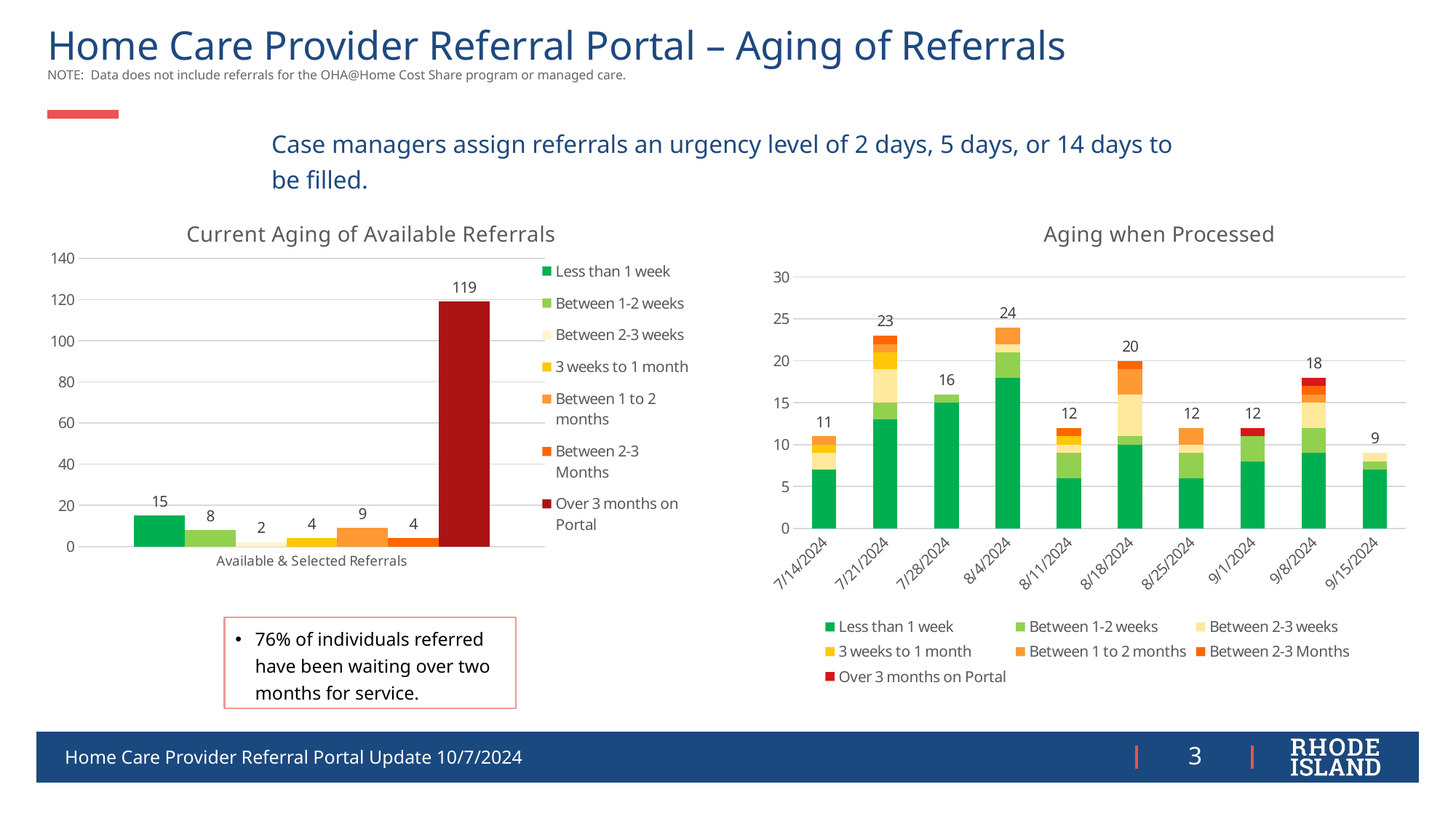
In the 'Aging when Processed' chart, which date has the lowest total? 9/15/2024 In the 'Aging when Processed' chart, what is the total for 8/4/2024? 24 In the 'Current Aging of Available Referrals' chart, what is the value for 'Less than 1 week'? 15 In the 'Current Aging of Available Referrals' chart, how many series does the legend list? 7 In the 'Aging when Processed' chart, what is the difference between the totals for 7/21/2024 and 7/28/2024? 7 In the 'Aging when Processed' chart, how many dates are shown on the x axis? 10 In the 'Current Aging of Available Referrals' chart, which series has the lowest value? Between 2-3 weeks In the 'Aging when Processed' chart, which date has the highest total? 8/4/2024 What kind of chart is 'Aging when Processed'? Stacked bar chart In the 'Current Aging of Available Referrals' chart, what is the difference between 'Over 3 months on Portal' and 'Less than 1 week'? 104 In the 'Current Aging of Available Referrals' chart, which is larger: 'Between 1-2 weeks' or 'Between 1 to 2 months'? Between 1 to 2 months In the 'Current Aging of Available Referrals' chart, what is the value for 'Over 3 months on Portal'? 119